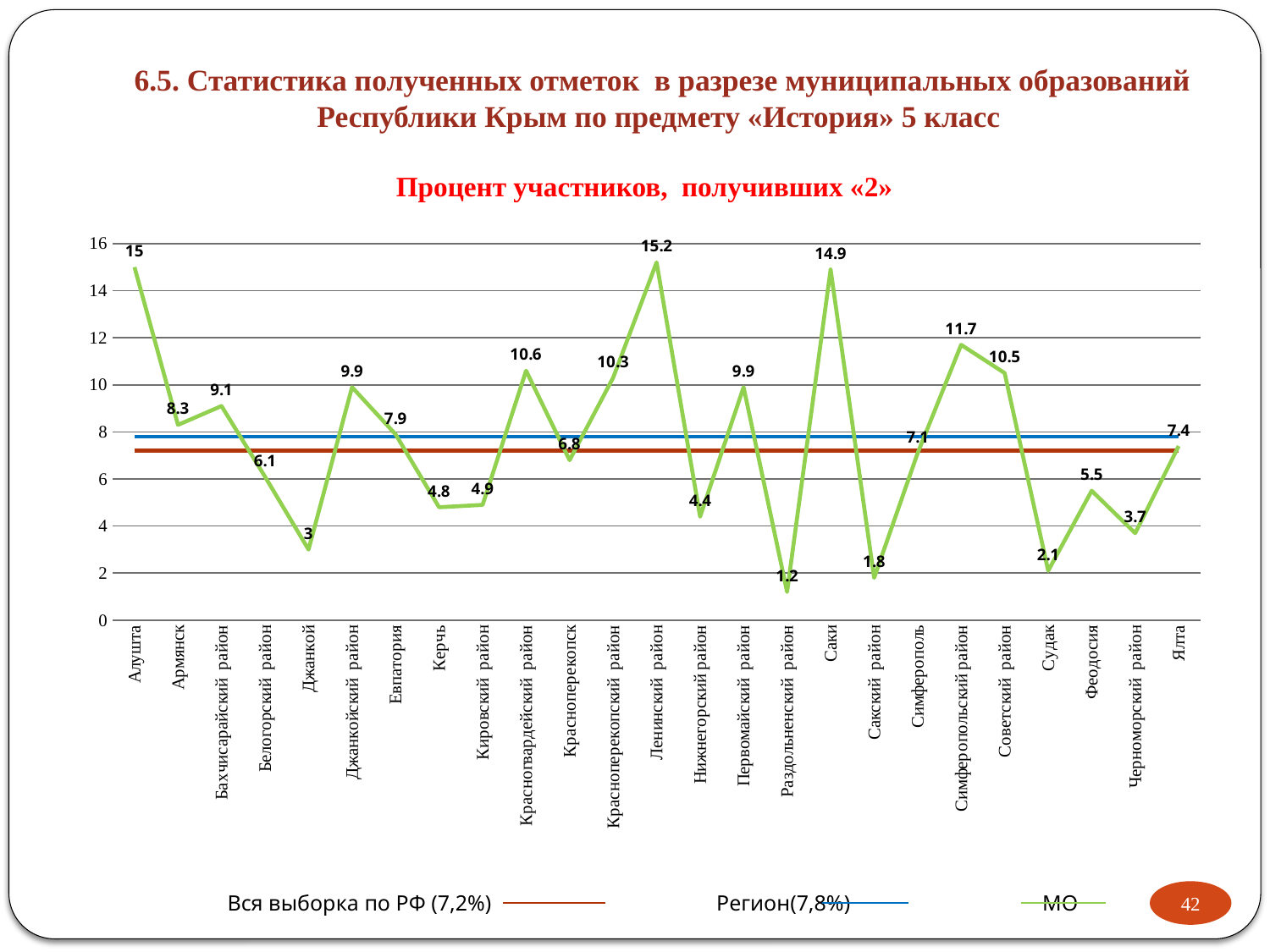
What is the value for Ленинский район? 15.2 What is the difference between the values for Алушта and Джанкой? 12 Which municipality has the lowest value on the chart? Раздольненский район Which municipality has the highest value on the chart? Ленинский район What value does the legend give for the series 'Регион'? 7,8% How many series does the legend list? 3 What kind of chart is shown on the slide? line chart How many municipalities are plotted on the x axis? 25 Is the value for Красногвардейский район greater or less than 10? greater What is the value for Симферопольский район? 11.7 Which is larger, the value for Саки or the value for Советский район? Саки What is the value for Раздольненский район? 1.2